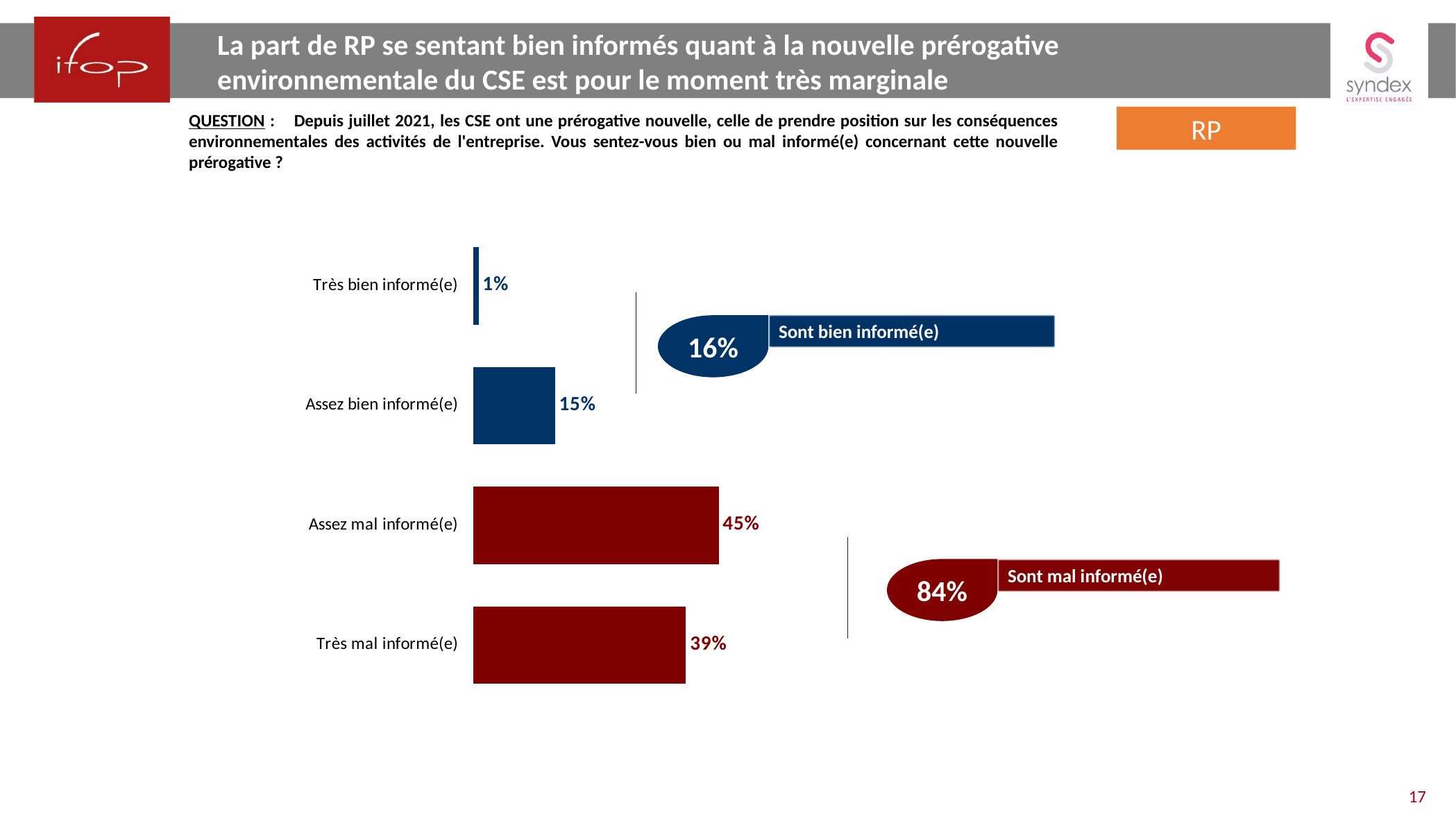
What kind of chart is shown on the slide? Bar chart What is the value for "Très mal informé(e)"? 39% How many categories are shown in the chart? 4 What percentage is shown in the callout labelled "Sont bien informé(e)"? 16% What is the difference between "Assez mal informé(e)" and "Très mal informé(e)"? 6% What is the value for "Très bien informé(e)"? 1% Which category has the highest value? Assez mal informé(e) What is the value for "Assez mal informé(e)"? 45% Which is larger, "Assez bien informé(e)" or "Très mal informé(e)"? Très mal informé(e) What is the value for "Assez bien informé(e)"? 15% What percentage is shown in the callout labelled "Sont mal informé(e)"? 84% Which category has the lowest value? Très bien informé(e)